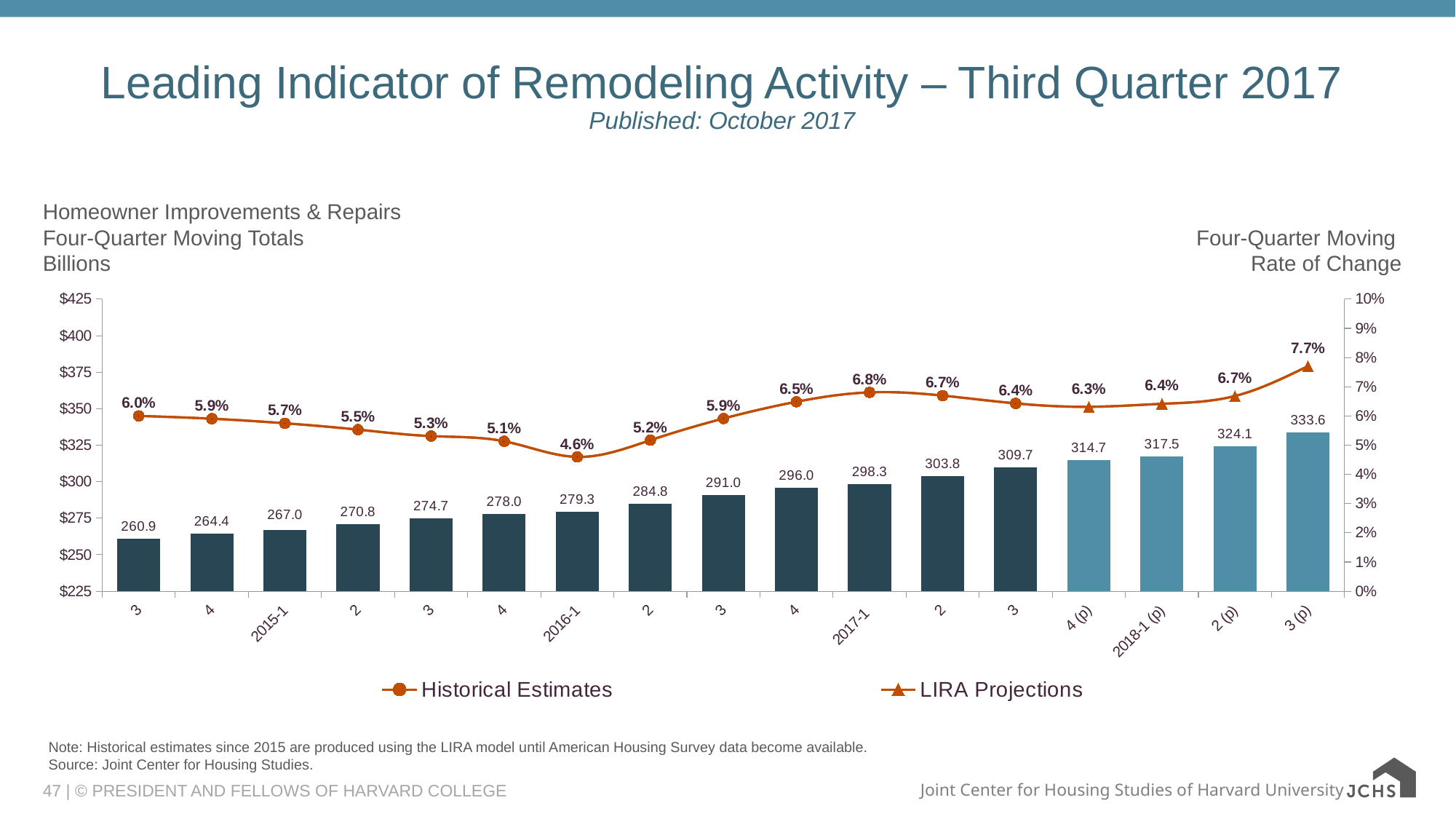
What kind of chart is this? Combined bar and line chart Do the four-quarter moving total bars rise or fall from left to right? Rise Which period has the lowest four-quarter moving total bar? 3 (2014) What is the projected four-quarter moving total for 3 (p) of 2018? 333.6 Which period has the lowest four-quarter moving rate of change? 2016-1 Which is larger, the rate of change for 2017-1 or for 2 (p) of 2018? 2017-1 What is the four-quarter moving total (in billions) for 2017-1? 298.3 What is the four-quarter moving rate of change for 2016-1? 4.6% What is the difference between the four-quarter moving totals for 2 (p) and 2018-1 (p)? 6.6 How many periods are shown on the x axis? 17 How many series does the legend list? 2 Which period has the highest four-quarter moving rate of change? 3 (p)